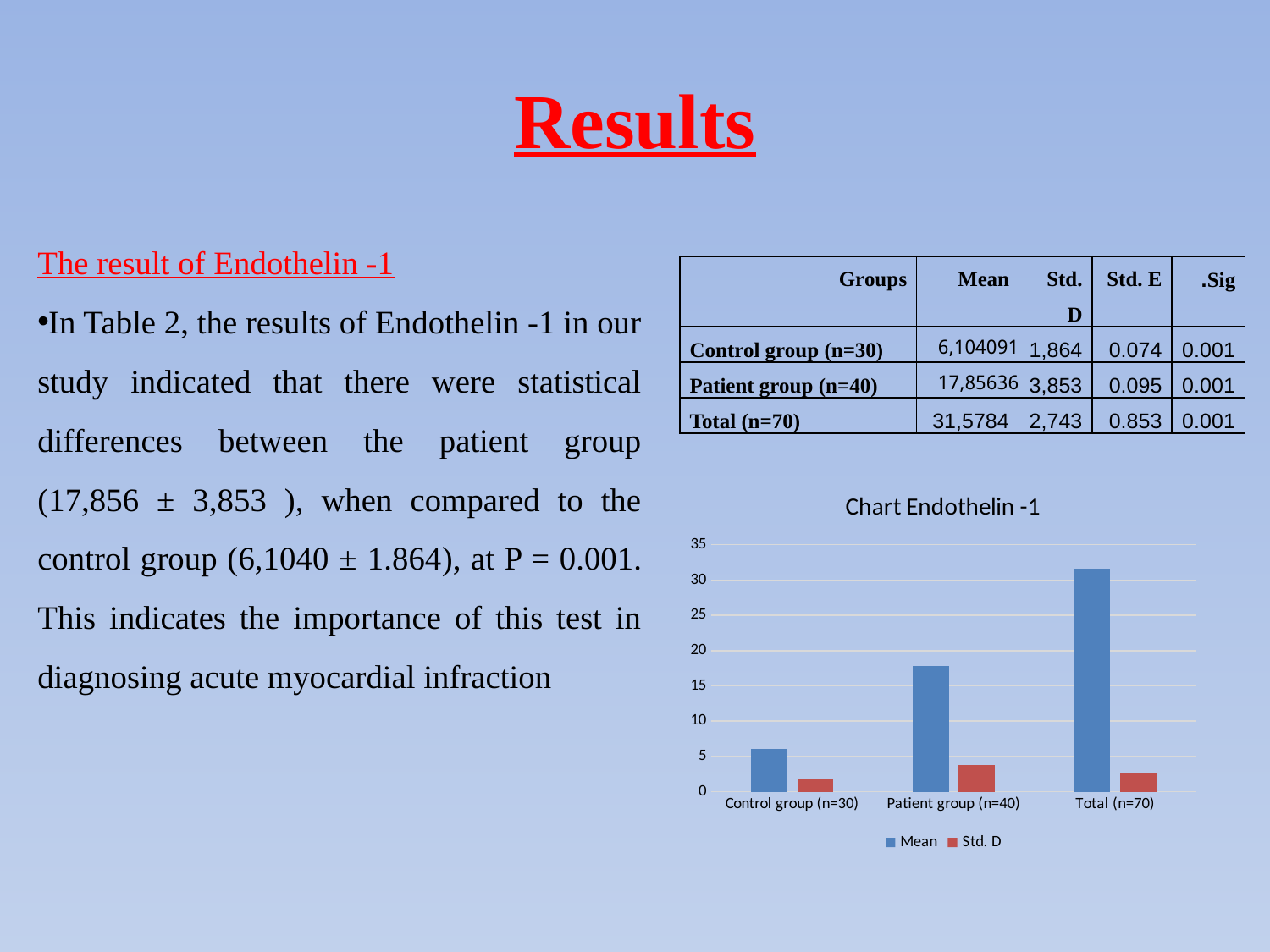
Is the Mean value for Control group (n=30) greater or less than 5? greater How many series does the legend of the chart list? 2 Which group has the highest Mean bar in the chart? Total (n=70) Is the Mean value for Total (n=70) greater or less than 30? greater Which group has the lowest Mean bar in the chart? Control group (n=30) What is the title of the chart on the slide? Chart Endothelin -1 Is the Mean value for Patient group (n=40) greater or less than 20? less Which is larger in the chart: the Mean for Patient group (n=40) or the Mean for Total (n=70)? Total (n=70) What type of chart is shown under the title "Chart Endothelin -1"? Bar chart How many groups are shown along the x axis of the chart? 3 Do the Mean bars rise or fall from Control group (n=30) to Total (n=70)? rise Which group has the tallest Std. D bar in the chart? Patient group (n=40)